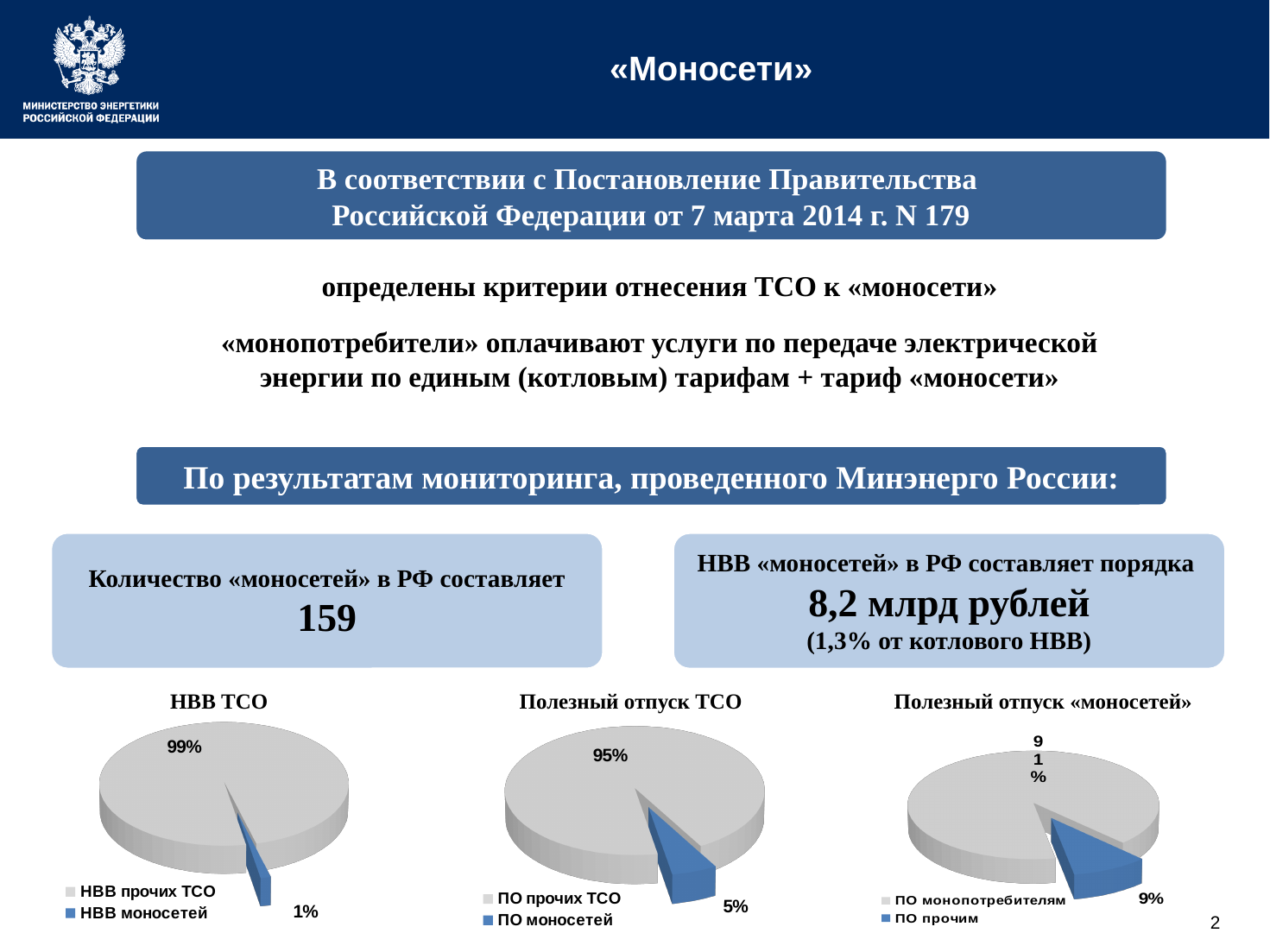
In the «НВВ ТСО» pie chart, which slice is the largest? НВВ прочих ТСО How many slices does the «Полезный отпуск ТСО» pie chart have? 2 In the «Полезный отпуск ТСО» pie chart, what share is labelled for «ПО моносетей»? 5% In the «НВВ ТСО» pie chart, what share is labelled for «НВВ прочих ТСО»? 99% In the «Полезный отпуск «моносетей»» pie chart, which is larger: «ПО монопотребителям» or «ПО прочим»? ПО монопотребителям In the «Полезный отпуск «моносетей»» pie chart, what share is labelled for «ПО прочим»? 9% In the «Полезный отпуск ТСО» pie chart, what is the difference between the shares of «ПО прочих ТСО» and «ПО моносетей»? 90% In the «Полезный отпуск «моносетей»» pie chart, what share is labelled for «ПО монопотребителям»? 91% In the «Полезный отпуск ТСО» pie chart, which slice is the smallest? ПО моносетей In the «НВВ ТСО» pie chart, what share is labelled for «НВВ моносетей»? 1% What type of chart is the «НВВ ТСО» chart? Pie chart In the «Полезный отпуск ТСО» pie chart, what share is labelled for «ПО прочих ТСО»? 95%